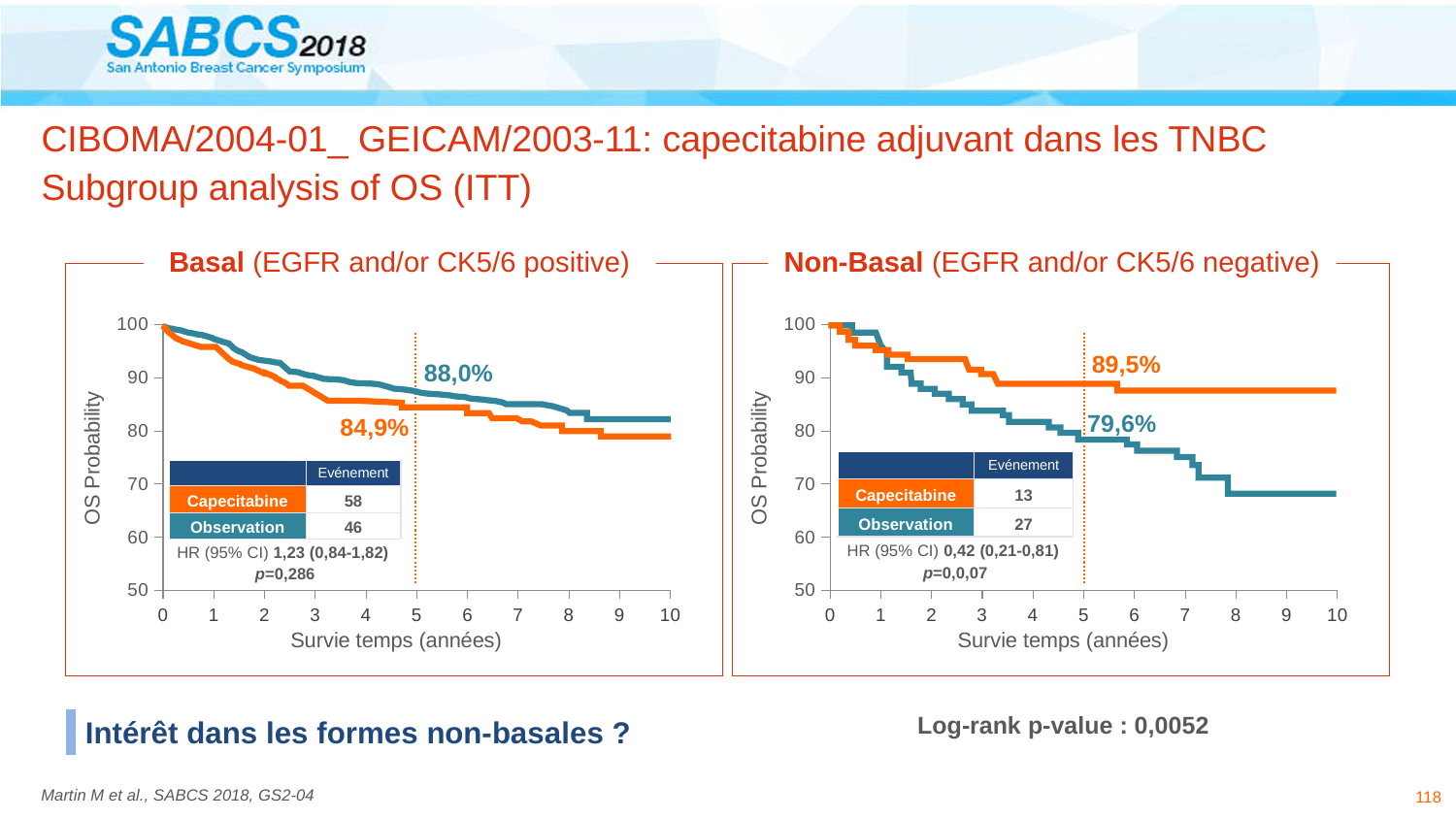
What is the label of the x axis in both charts? Survie temps (années) In the Non-Basal chart, what is the 5-year OS probability labelled for the Capecitabine (orange) curve? 89,5% In the Non-Basal chart, how many events are listed for the Observation arm? 27 In the Basal chart, how many events are listed for the Capecitabine arm? 58 In the Basal chart, which arm has the higher labelled 5-year OS probability, Capecitabine or Observation? Observation What kind of chart is shown in each panel? Line chart (Kaplan-Meier survival curve) In the Basal chart, what is the 5-year OS probability labelled for the Capecitabine (orange) curve? 84,9% In the Non-Basal chart, what is the hazard ratio (95% CI) shown? 0,42 (0,21-0,81) In the Basal chart, what is the 5-year OS probability labelled for the Observation (teal) curve? 88,0% In the Non-Basal chart, what is the difference between the labelled 5-year OS probabilities of Capecitabine and Observation? 9,9% In the Non-Basal chart, what is the 5-year OS probability labelled for the Observation (teal) curve? 79,6%